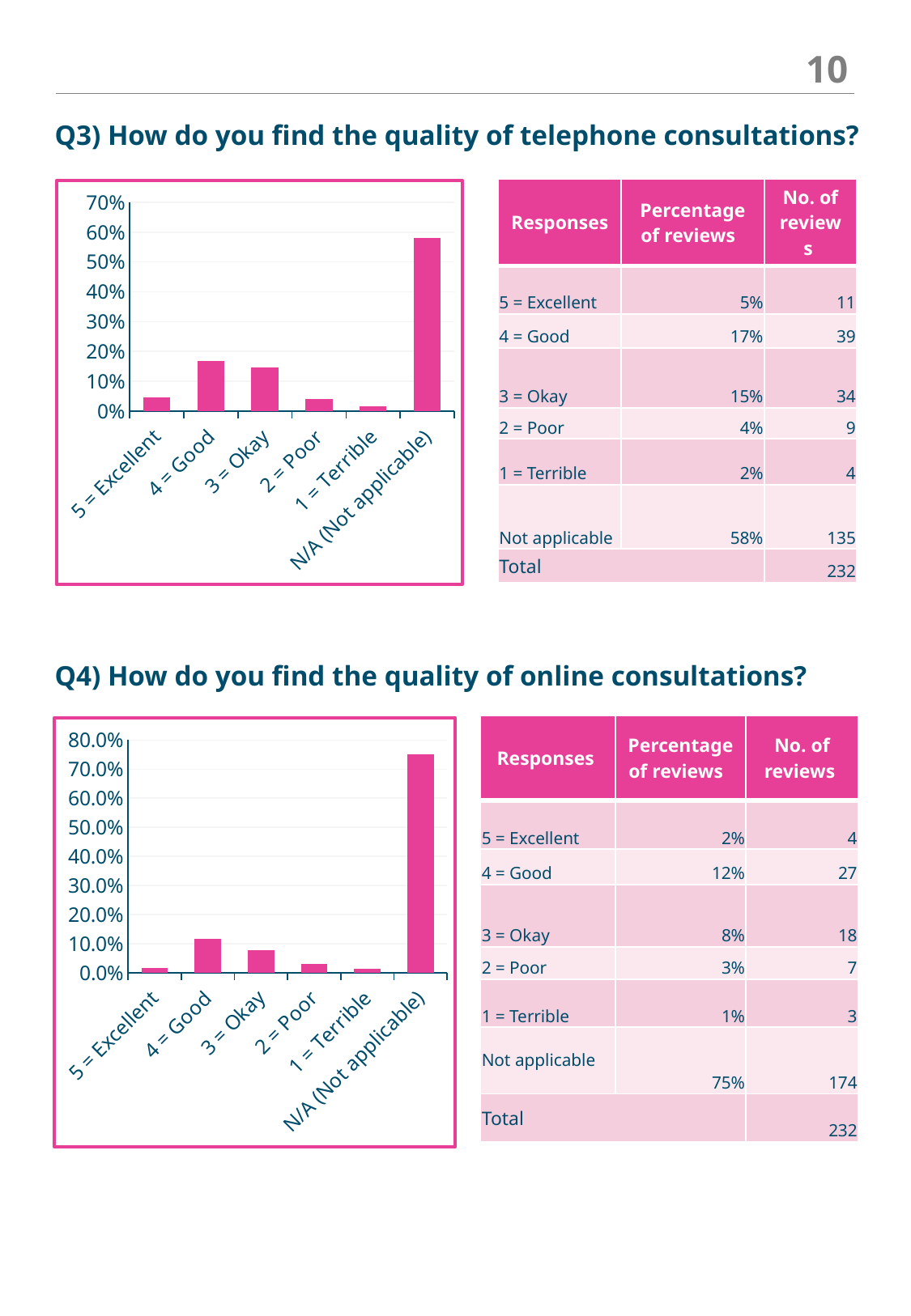
On the Q4 chart (bottom chart), is the value for 4 = Good greater or less than 20.0%? less On the Q3 chart (top chart), which is larger, the bar for 4 = Good or the bar for 2 = Poor? 4 = Good On the Q3 chart (top chart), which category has the highest bar? N/A (Not applicable) On the Q4 chart (bottom chart), which category has the lowest bar? 1 = Terrible On the Q4 chart (bottom chart), which is larger, the bar for 4 = Good or the bar for 3 = Okay? 4 = Good On the Q3 chart (top chart), is the value for 4 = Good greater or less than 10%? greater How many categories are plotted on the Q3 chart (top chart)? 6 What kind of chart is shown under Q3 (the top chart)? bar chart On the Q3 chart (top chart), which category has the lowest bar? 1 = Terrible On the Q4 chart (bottom chart), is the value for N/A (Not applicable) greater or less than 70.0%? greater On the Q4 chart (bottom chart), which category has the highest bar? N/A (Not applicable)